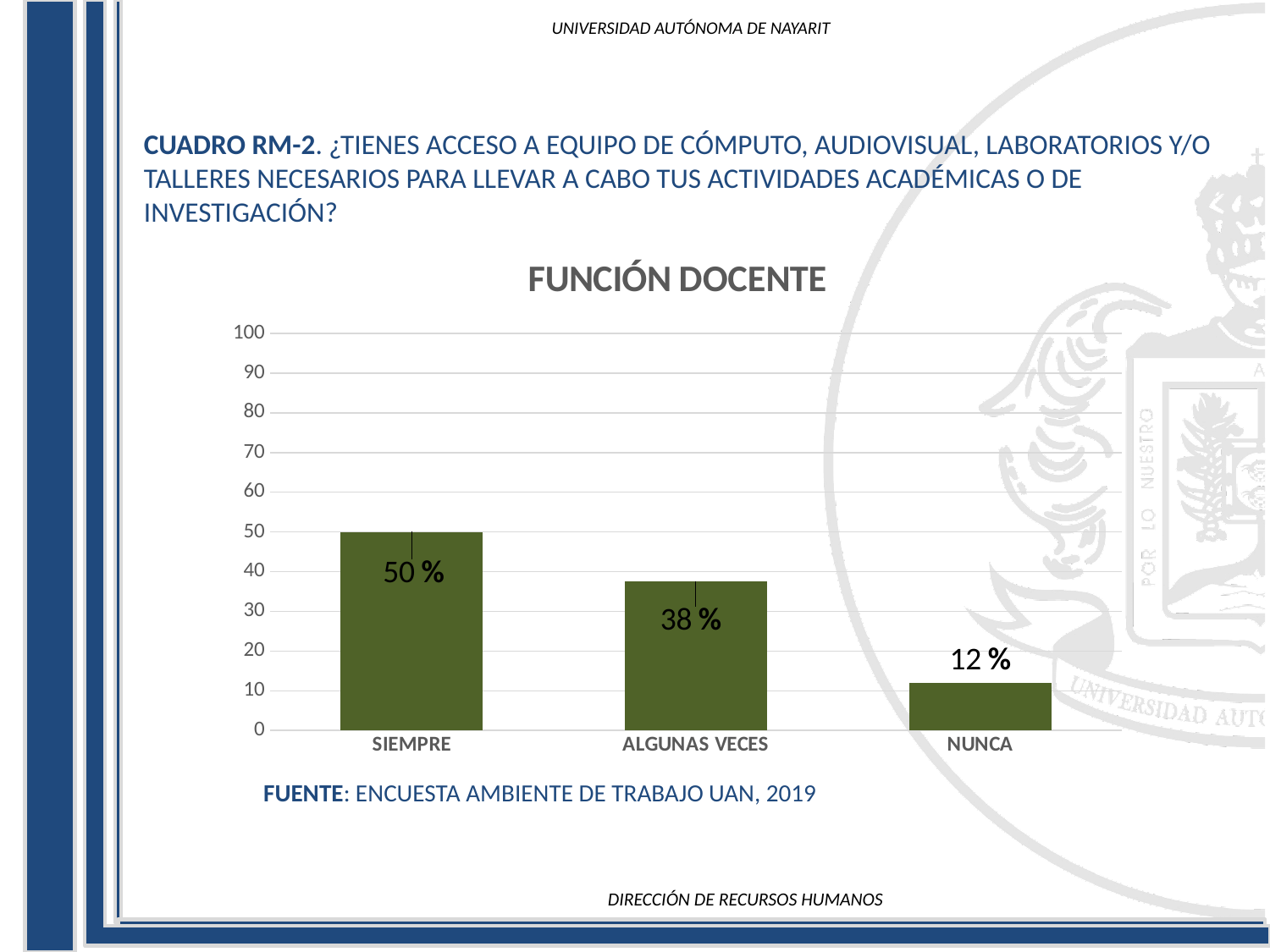
What is the title of the chart? FUNCIÓN DOCENTE What is the value for SIEMPRE? 50 % What is the value for NUNCA? 12 % What is the value for ALGUNAS VECES? 38 % What is the difference between the values for SIEMPRE and ALGUNAS VECES? 12 % Is the value for ALGUNAS VECES greater or less than 40? less What kind of chart is shown? bar chart How many categories are shown on the x axis? 3 What is the difference between the values for ALGUNAS VECES and NUNCA? 26 % Which category has the lowest value? NUNCA Which is larger, the value for ALGUNAS VECES or the value for NUNCA? ALGUNAS VECES Which category has the highest value? SIEMPRE